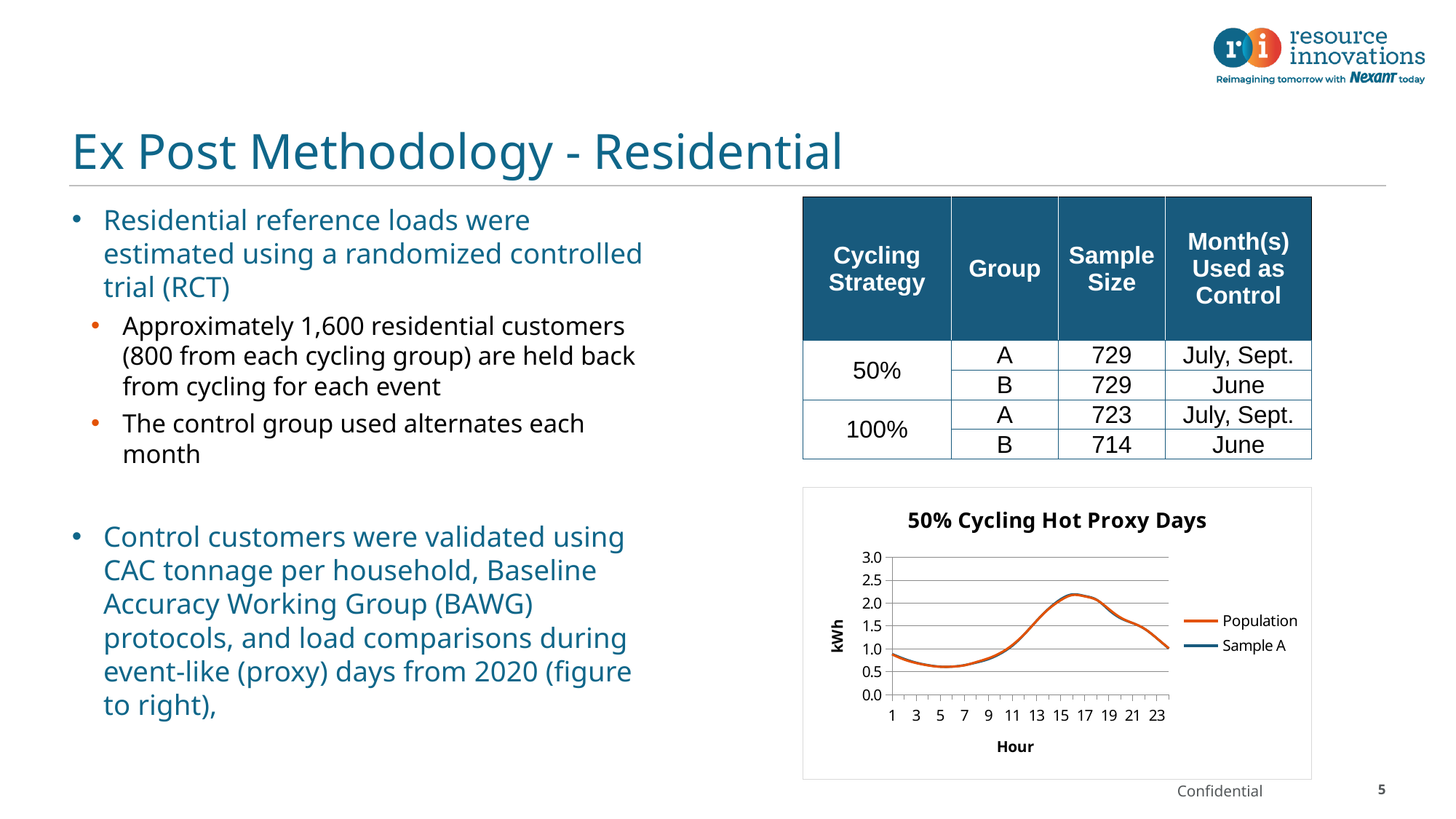
How many series does the legend of the chart list? 2 Does the Population line rise or fall between hour 5 and hour 15? Rises Is the Population value at hour 16 greater or less than 2.0 kWh? greater What is the title of the chart? 50% Cycling Hot Proxy Days Is the Population value at hour 16 higher or lower than at hour 1? Higher Is the Sample A value at hour 9 greater or less than 1.5 kWh? less Is the Population value at hour 5 greater or less than 1.0 kWh? less Does the Population line rise or fall between hour 17 and hour 23? Falls What kind of chart is shown on the slide? Line chart What are the two series named in the chart legend? Population and Sample A What is the highest value shown on the y axis of the chart? 3.0